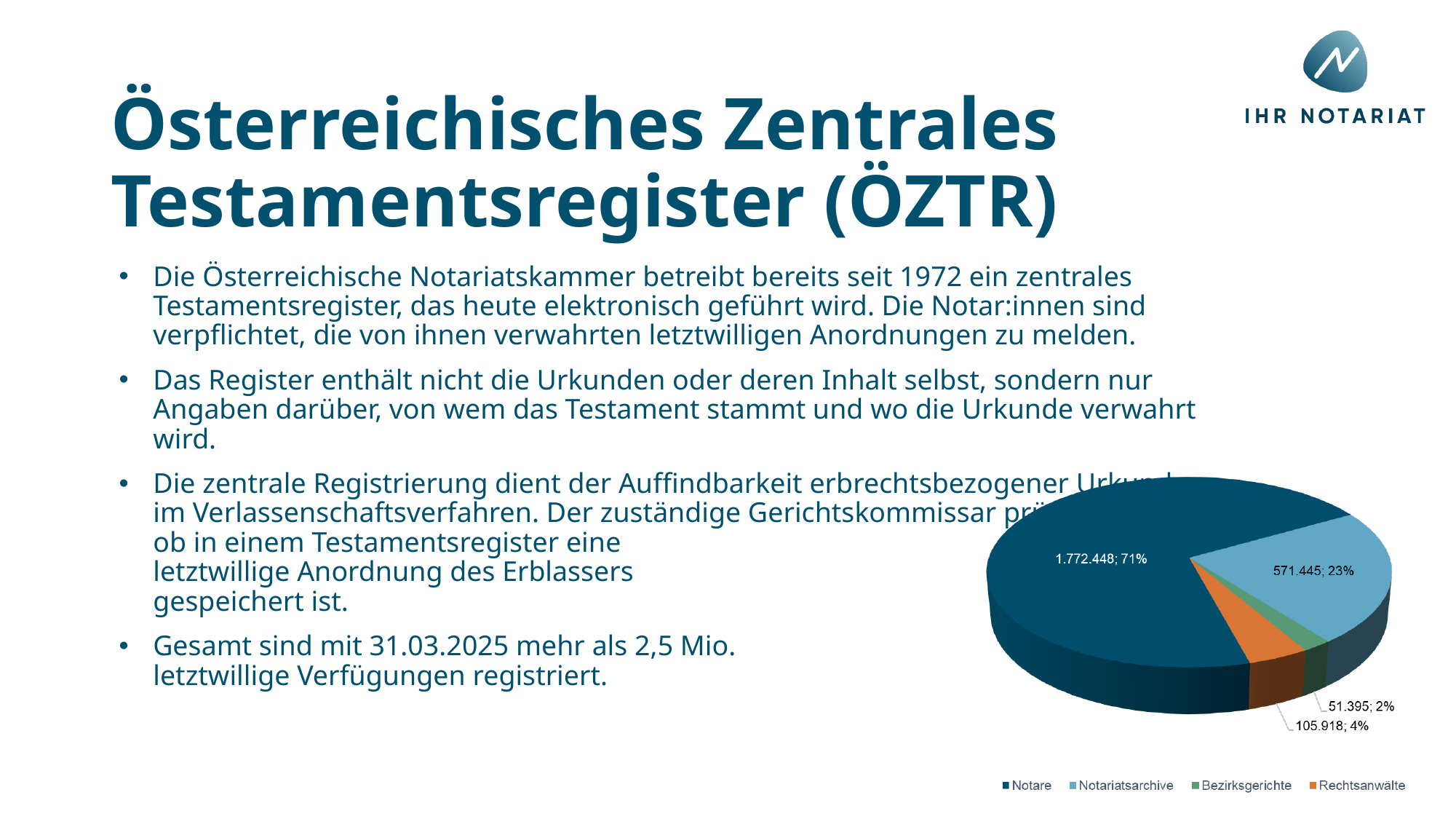
What value is shown for Notariatsarchive in the pie chart? 571.445 What value is shown for Notare in the pie chart? 1.772.448 What value is shown for Bezirksgerichte in the pie chart? 51.395 What is the difference between the values for Notare and Notariatsarchive in the pie chart? 1.201.003 What value is shown for Rechtsanwälte in the pie chart? 105.918 How many series does the legend of the pie chart list? 4 What share of the pie does Notariatsarchive account for? 23% Which is larger in the pie chart, Rechtsanwälte or Bezirksgerichte? Rechtsanwälte What share of the pie does Notare account for? 71% What kind of chart is shown on the slide? pie chart Which category has the smallest slice in the pie chart? Bezirksgerichte Which category has the largest slice in the pie chart? Notare